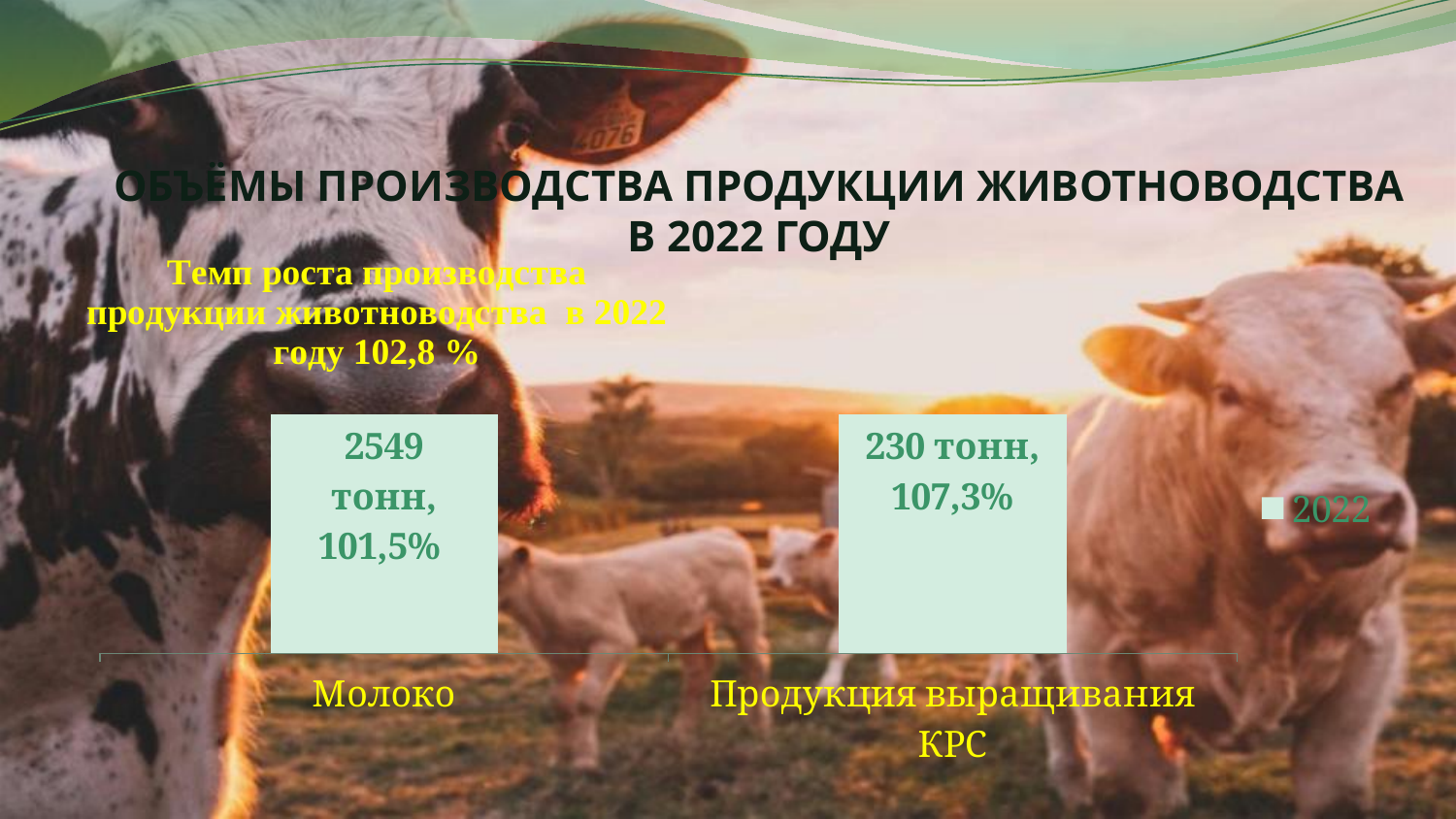
What kind of chart is shown on the slide? Bar chart What data label is shown on the bar for Продукция выращивания КРС? 230 тонн, 107,3% What is the difference in tonnes between Молоко and Продукция выращивания КРС according to the data labels? 2319 тонн How many tonnes are shown for Молоко? 2549 тонн What entry is shown in the chart legend? 2022 What data label is shown on the bar for Молоко? 2549 тонн, 101,5% How many categories are shown on the chart? 2 How many series does the legend list? 1 What growth percentage is shown for Продукция выращивания КРС? 107,3% According to the data labels, which category has the higher growth percentage, Молоко or Продукция выращивания КРС? Продукция выращивания КРС What growth percentage is shown for Молоко? 101,5% According to the data labels, which category has the larger tonnage, Молоко or Продукция выращивания КРС? Молоко